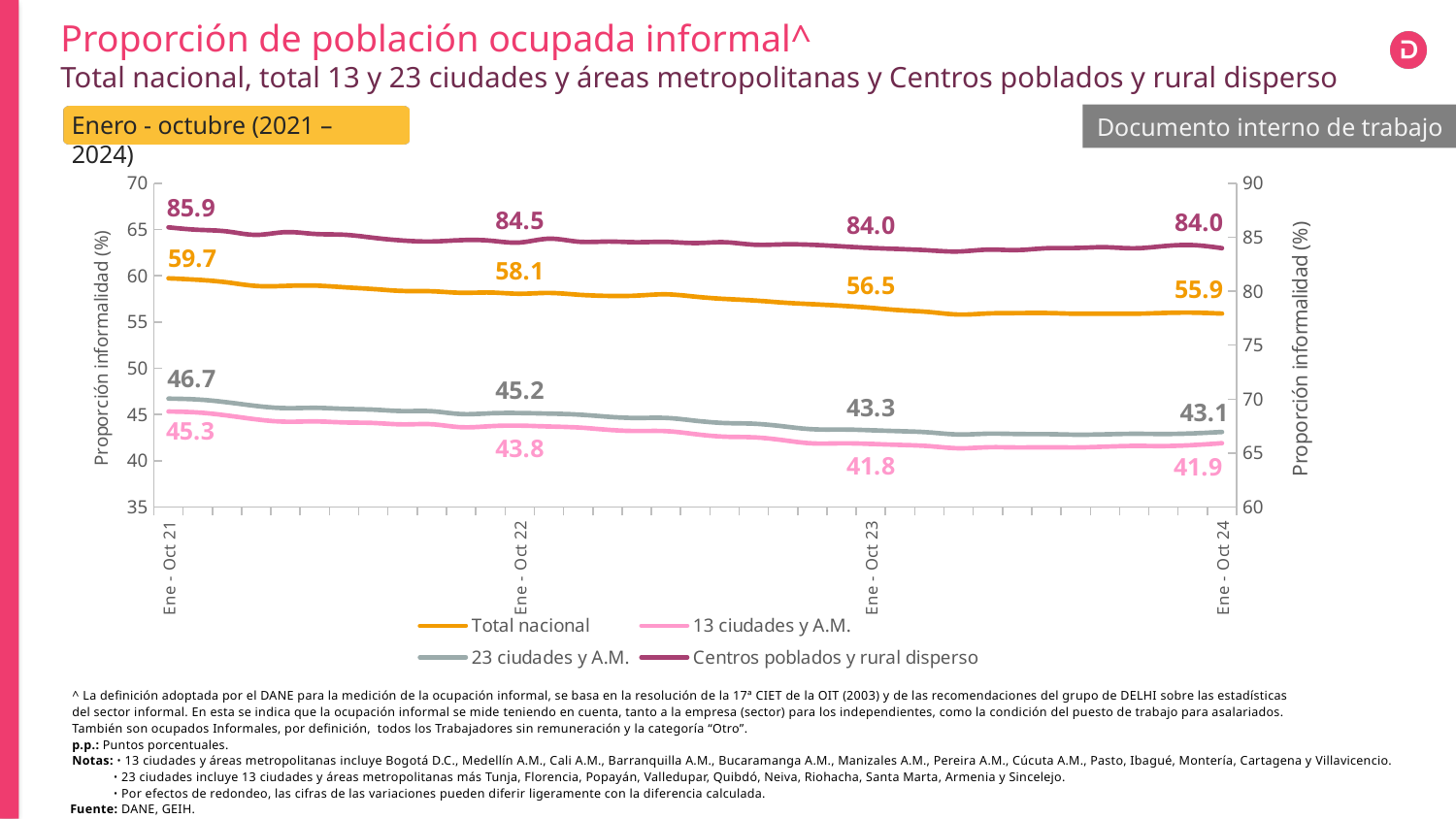
What is the difference between the Total nacional values at Ene - Oct 21 and Ene - Oct 24? 3.8 Which series has the lowest value at Ene - Oct 23? 13 ciudades y A.M. Which series has the highest value at Ene - Oct 24? Centros poblados y rural disperso What is the value for Total nacional at Ene - Oct 21? 59.7 Does the Total nacional series rise or fall from Ene - Oct 21 to Ene - Oct 24? Fall How many series does the legend list? 4 Which series is plotted in orange? Total nacional What is the value for Centros poblados y rural disperso at Ene - Oct 22? 84.5 Which is larger at Ene - Oct 22: the value for 23 ciudades y A.M. or the value for 13 ciudades y A.M.? 23 ciudades y A.M. What is the value for 23 ciudades y A.M. at Ene - Oct 23? 43.3 What is the value for 13 ciudades y A.M. at Ene - Oct 24? 41.9 What kind of chart is shown on the slide? Line chart